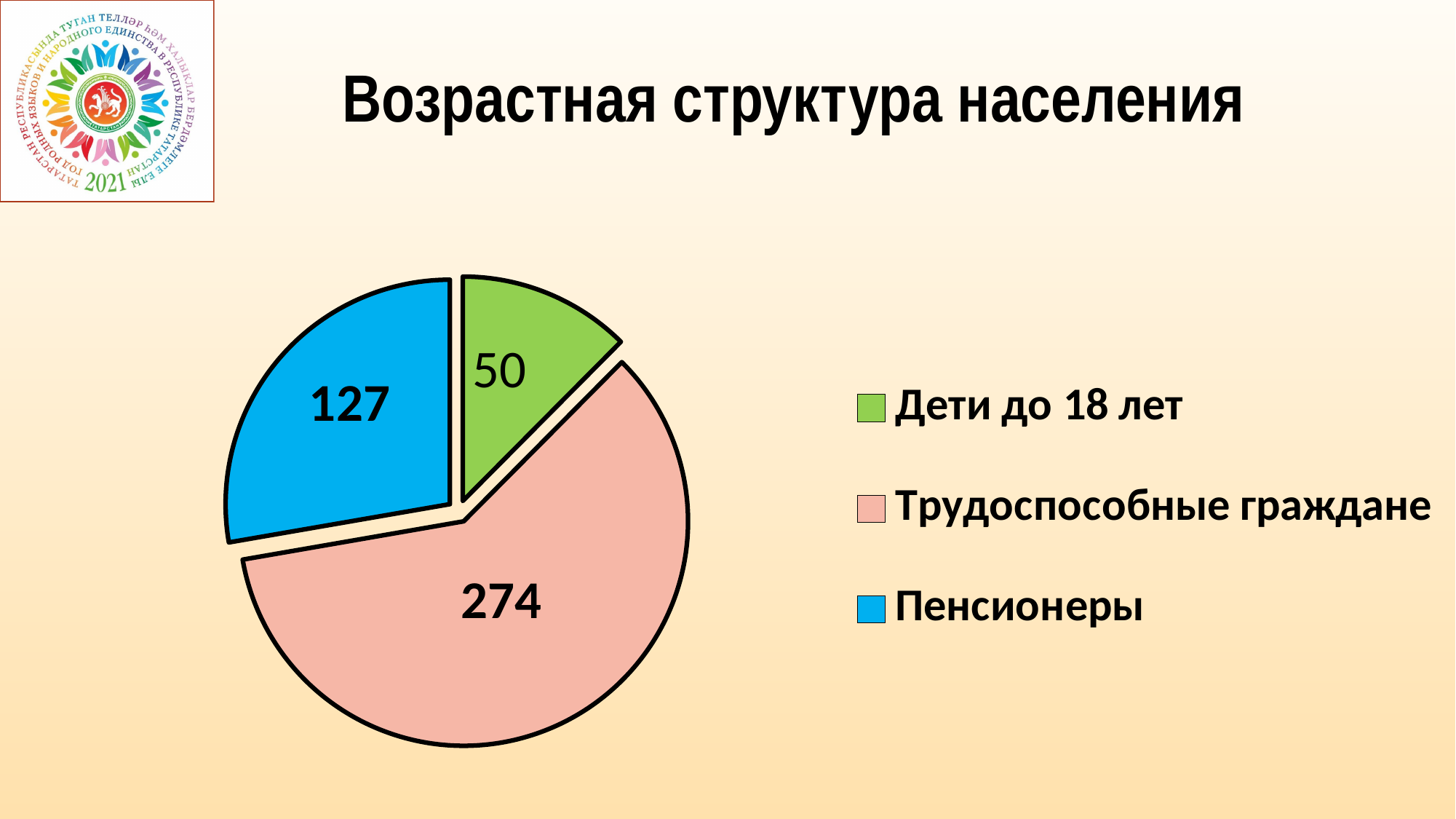
What is the total of all slices in the pie chart? 451 Which category has the largest slice of the pie? Трудоспособные граждане How many categories does the pie chart have? 3 What is the value for Трудоспособные граждане? 274 What is the value for Пенсионеры? 127 What is the title of the chart? Возрастная структура населения What is the difference between the values for Пенсионеры and Дети до 18 лет? 77 Which is larger: Пенсионеры or Дети до 18 лет? Пенсионеры What is the difference between the values for Трудоспособные граждане and Пенсионеры? 147 What type of chart is shown on the slide? Pie chart Which category has the smallest slice of the pie? Дети до 18 лет What is the value for Дети до 18 лет? 50